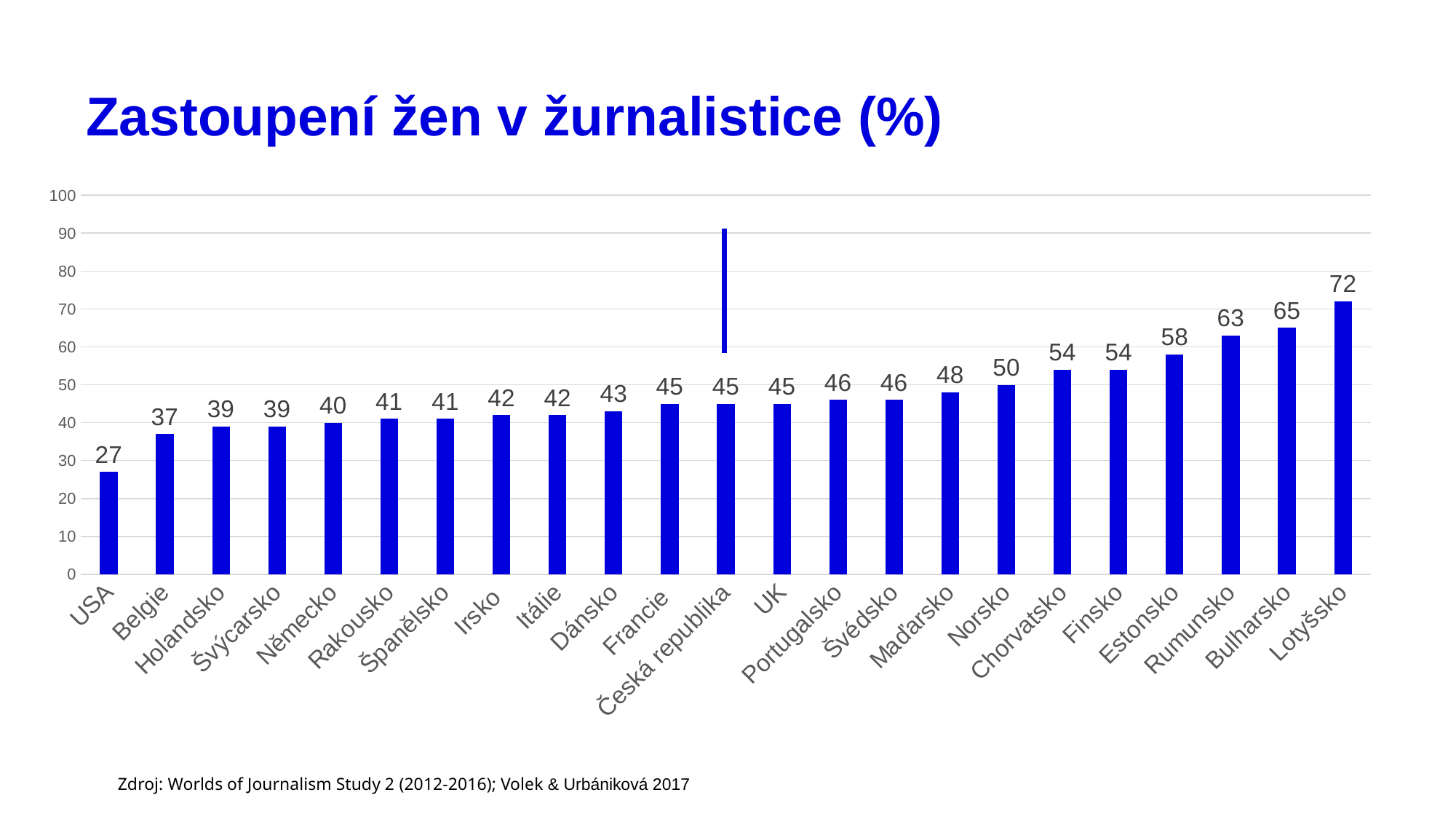
Is the value for Rumunsko greater or less than 60? greater What is the difference between the values for Lotyšsko and USA? 45 What is the title of the chart? Zastoupení žen v žurnalistice (%) What is the difference between the values for Bulharsko and Estonsko? 7 What kind of chart is shown on the slide? bar chart What is the value for Lotyšsko? 72 How many countries are shown in the chart? 23 What is the value for Německo? 40 What is the value for Česká republika? 45 Which is larger, the value for Norsko or the value for Maďarsko? Norsko Which country has the highest value? Lotyšsko Which country has the lowest value? USA